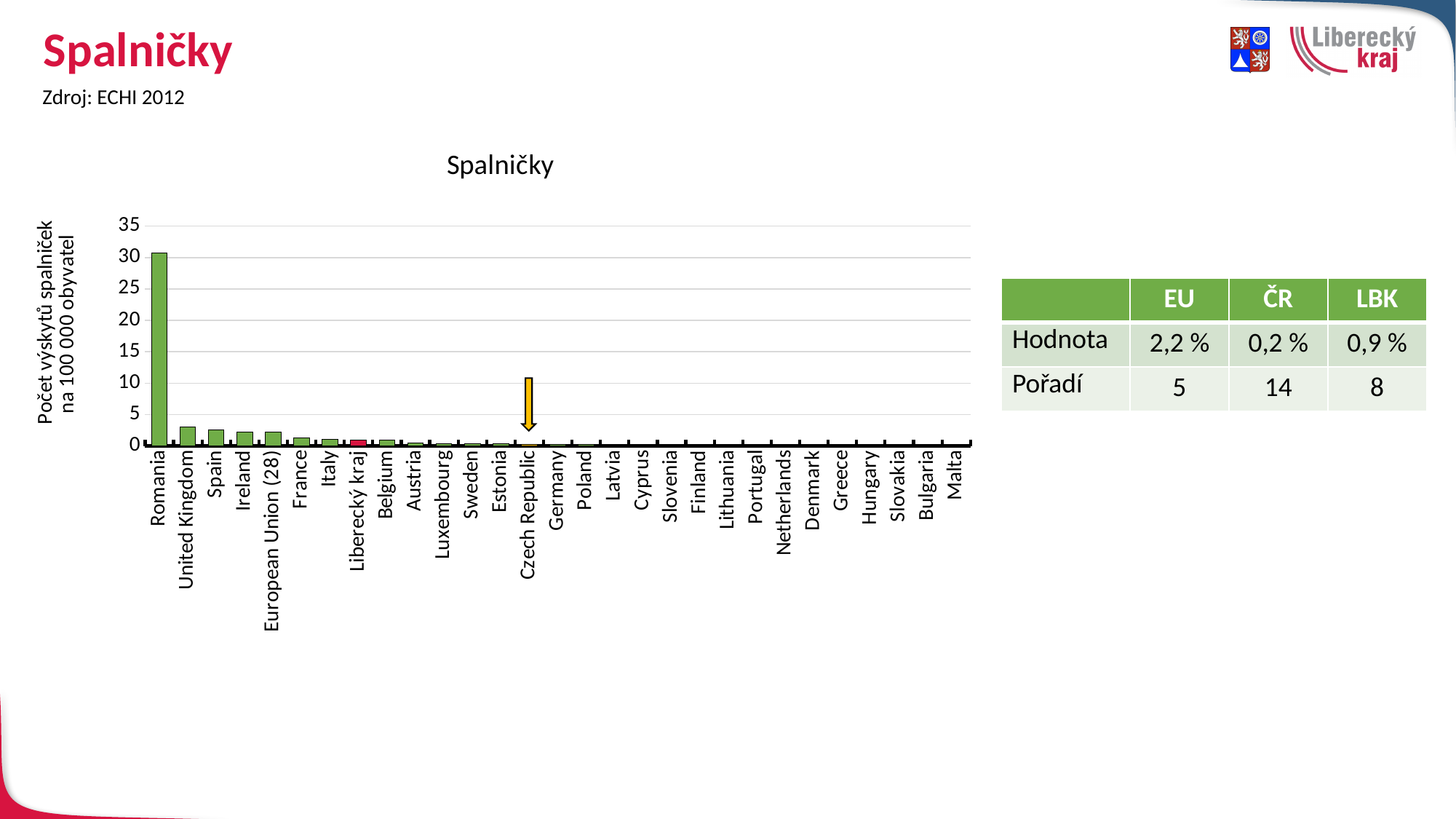
Which country has the highest number of measles cases per 100 000 inhabitants in the chart? Romania What is the title of the chart? Spalničky Is the value for Romania greater or less than 20? greater Which is larger, the value for Romania or the value for United Kingdom? Romania Is the value for Spain greater or less than 5? less How many categories are shown on the x axis of the chart? 29 Do the values rise or fall moving from left to right along the x axis? fall Which is larger, the value for United Kingdom or the value for Czech Republic? United Kingdom Is the value for Romania greater or less than 25? greater Which category's bar is highlighted in red in the chart? Liberecký kraj What kind of chart is shown on the slide? bar chart